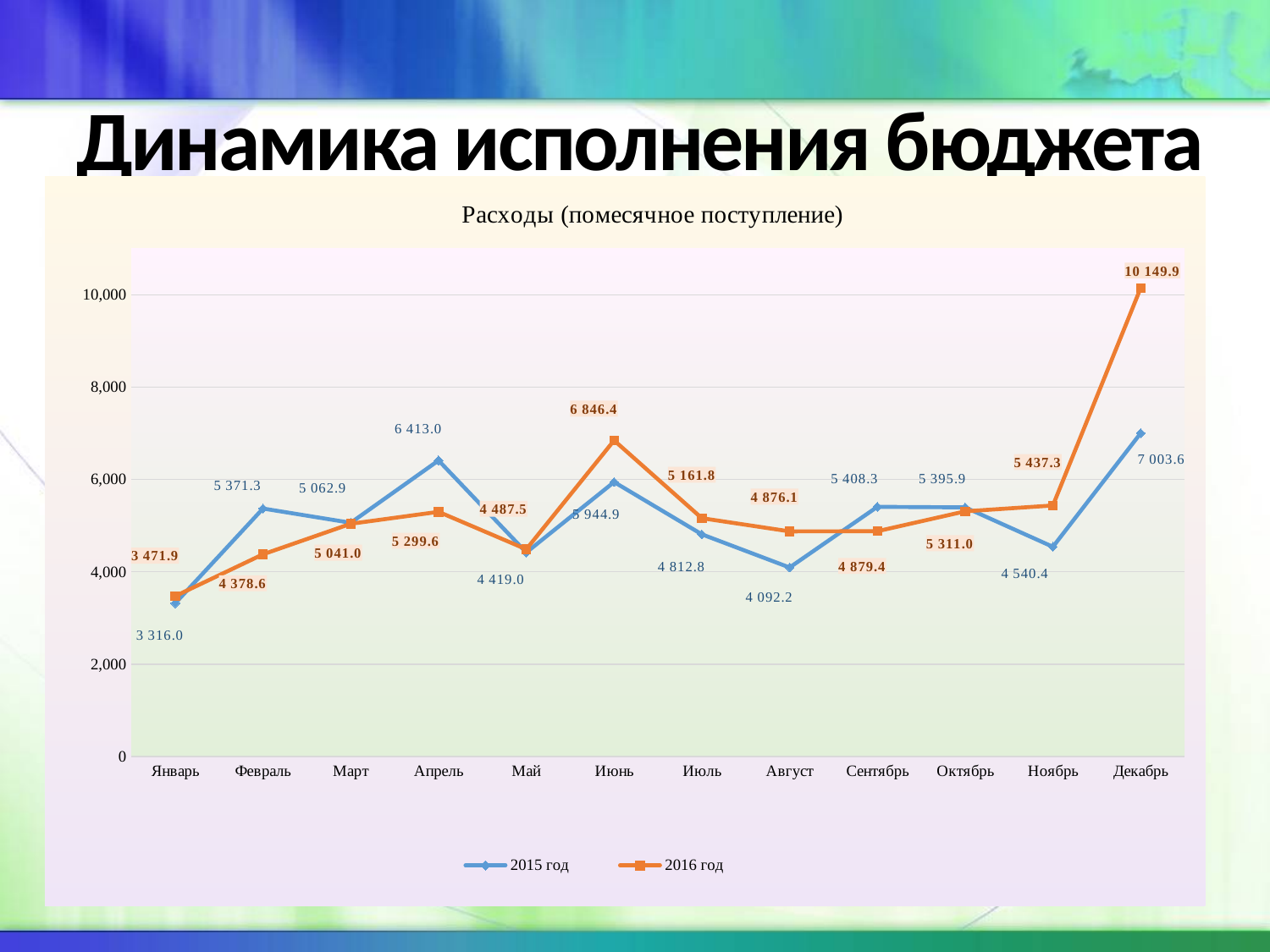
Which series has the larger value for Апрель, 2015 год or 2016 год? 2015 год What is the value for Август in the 2016 год series? 4 876.1 What is the value for Апрель in the 2015 год series? 6 413.0 What is the lowest value in the 2015 год series? 3 316.0 How many months are shown on the x axis? 12 What is the difference between the 2016 год and 2015 год values for Декабрь? 3 146.3 Which month has the highest value in the 2015 год series? Декабрь What is the difference between the 2016 год and 2015 год values for Июнь? 901.5 How many series does the legend list? 2 What is the value for Декабрь in the 2016 год series? 10 149.9 Which month has the lowest value in the 2016 год series? Январь What kind of chart is shown on the slide? Line chart